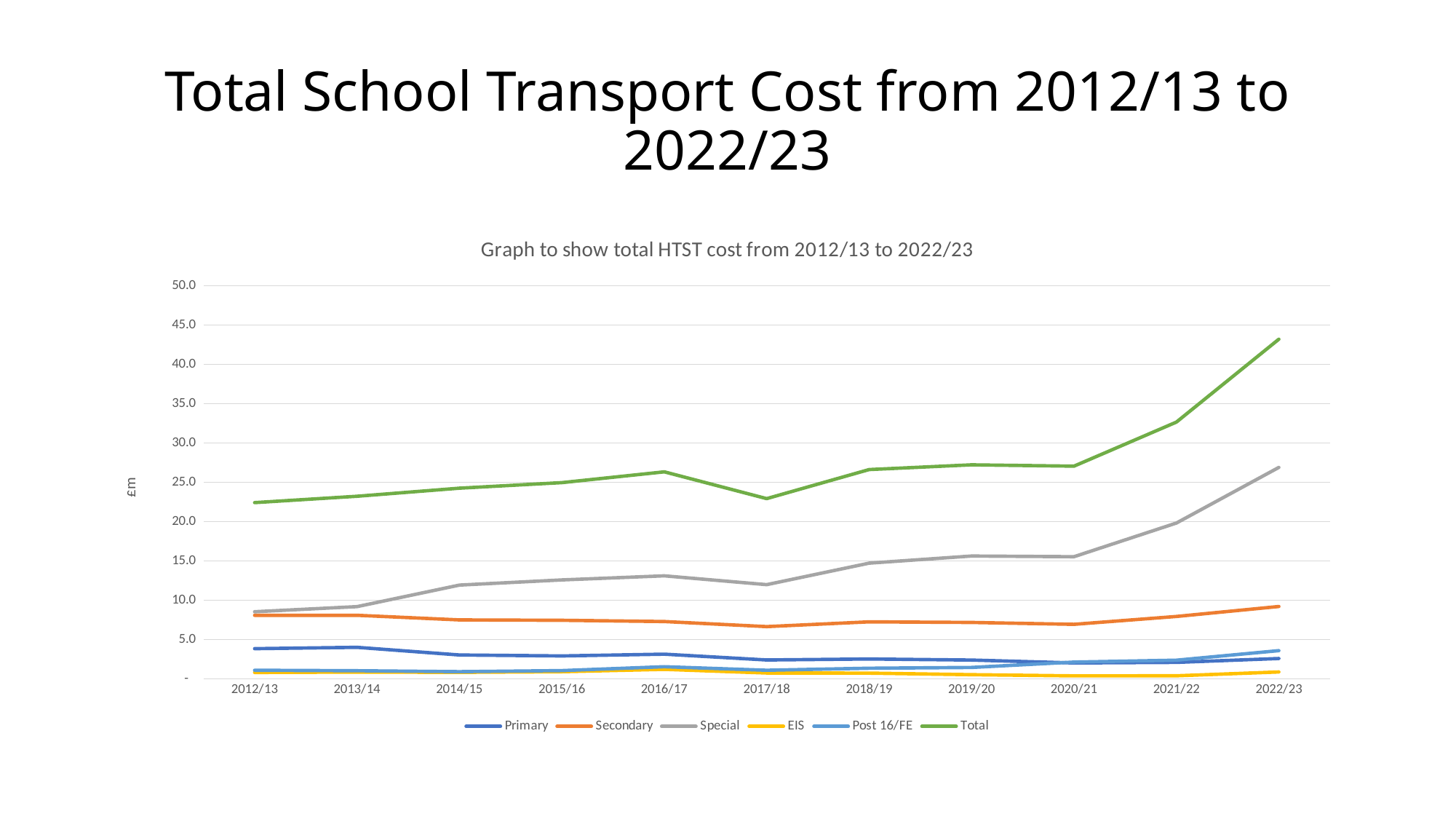
Is the value for Secondary in 2012/13 greater or less than 10? less Is the value for Total in 2017/18 greater or less than 25? less Which is larger in 2022/23, Special or Secondary? Special Which series has the lowest value in 2022/23? EIS Is the value for Total in 2022/23 greater or less than 40? greater What kind of chart is shown on the slide? line chart How many years are shown along the x axis? 11 What is the label on the y axis? £m Which series has the highest value in 2022/23? Total In which year is the Total series at its highest? 2022/23 How many series does the legend list? 6 Does the Total series rise or fall from 2020/21 to 2022/23? rises